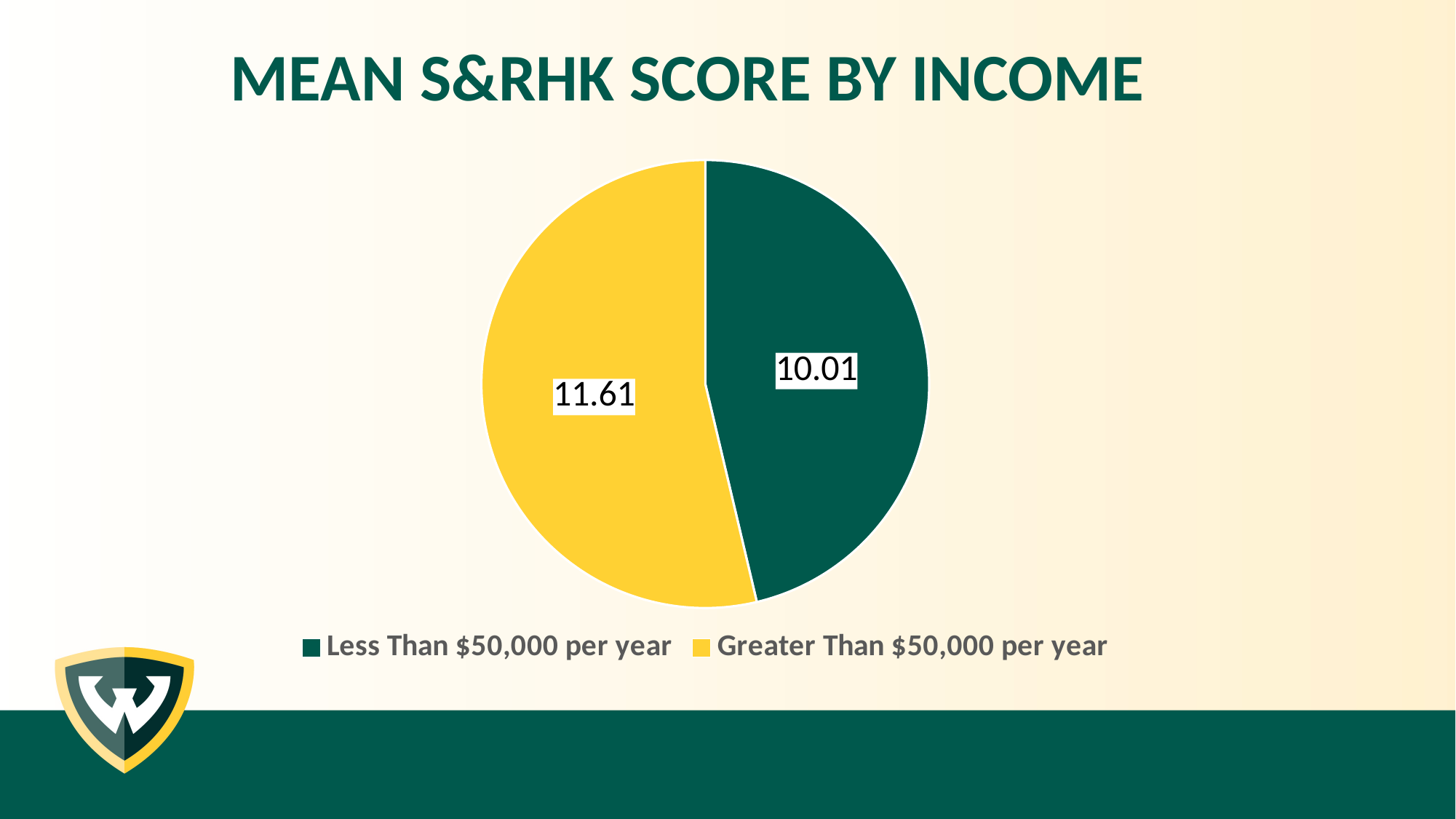
What is the sum of the two values shown in the pie chart? 21.62 Which colour represents the Less Than $50,000 per year group in the pie chart? Green Is the mean S&RHK score larger for the Less Than $50,000 per year group or the Greater Than $50,000 per year group? Greater Than $50,000 per year What type of chart is shown on the slide? Pie chart What share of the pie does the Greater Than $50,000 per year slice represent, to one decimal place? 53.7% What is the mean S&RHK score for the Less Than $50,000 per year group? 10.01 What is the difference between the mean S&RHK scores of the Greater Than $50,000 and Less Than $50,000 groups? 1.60 What is the mean S&RHK score for the Greater Than $50,000 per year group? 11.61 Which income group has the higher mean S&RHK score? Greater Than $50,000 per year What is the title of the chart? MEAN S&RHK SCORE BY INCOME Which income group has the lower mean S&RHK score? Less Than $50,000 per year How many income groups are shown in the pie chart? 2